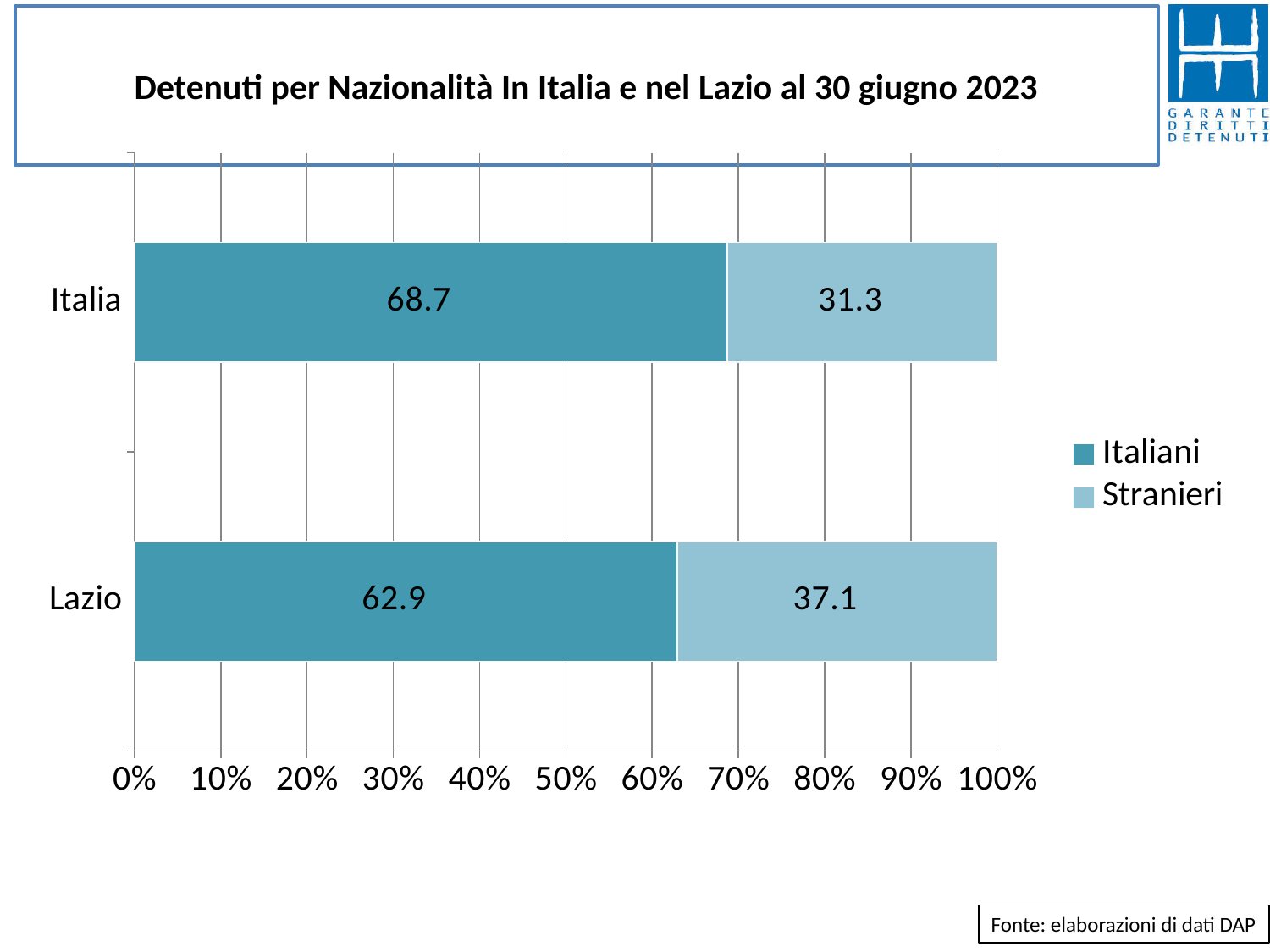
How many categories are shown on the chart? 2 What is the value for Italiani in Italia? 68.7 What is the difference between the Stranieri values for Lazio and Italia? 5.8 What kind of chart is shown on the slide? Stacked bar chart What is the value for Stranieri in Lazio? 37.1 Which category has the lowest Italiani value? Lazio Which category has the higher Stranieri value, Italia or Lazio? Lazio How many series does the legend list? 2 What is the difference between the Italiani values for Italia and Lazio? 5.8 What is the value for Italiani in Lazio? 62.9 What is the total of the stacked bar for Italia? 100 What is the value for Stranieri in Italia? 31.3